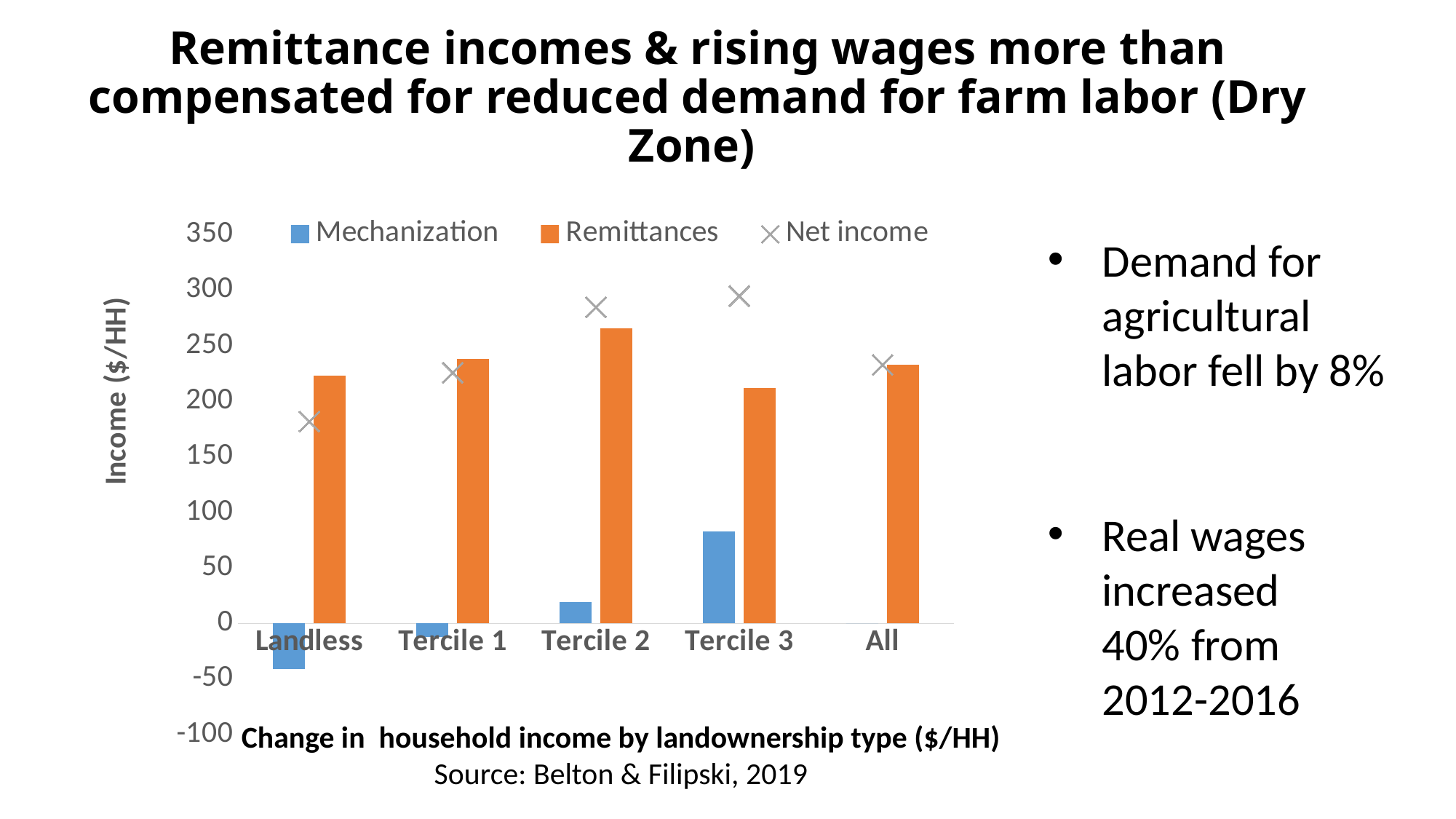
Which category has the highest Mechanization value? Tercile 3 Which category has the lowest Remittances value? Tercile 3 How many series does the chart legend list? 3 Which has the larger Net income value, Landless or Tercile 3? Tercile 3 Is the Net income value for Landless greater or less than 200? less Is the Remittances value for Tercile 2 greater or less than 250? greater How many landownership categories are shown on the x axis? 5 Which category has the highest Remittances value? Tercile 2 Is the Mechanization value for Tercile 3 greater or less than 100? less Which category has the lowest Mechanization value? Landless What kind of chart is shown on the slide? Bar chart What is the label on the y axis of the chart? Income ($/HH)